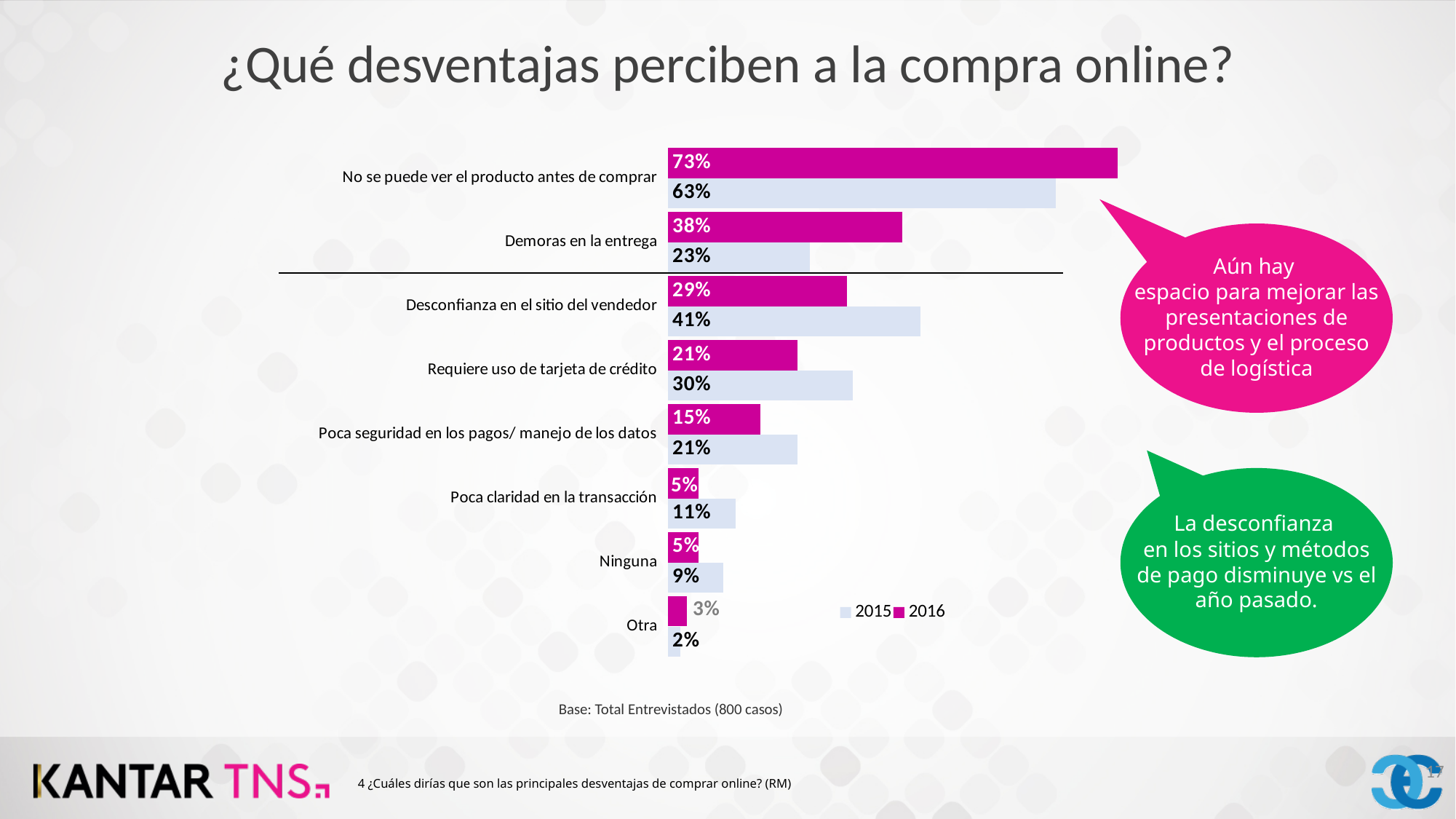
How many categories are shown in the chart? 8 Which category has the highest 2016 value? No se puede ver el producto antes de comprar What kind of chart is shown on the slide? Bar chart What is the 2015 value for "Desconfianza en el sitio del vendedor"? 41% What is the difference between the 2015 and 2016 values for "Desconfianza en el sitio del vendedor"? 12 percentage points What is the 2016 value for "No se puede ver el producto antes de comprar"? 73% For "Requiere uso de tarjeta de crédito", which year has the larger value, 2015 or 2016? 2015 How many series does the legend list? 2 Which category has the lowest 2015 value? Otra What is the difference between the 2016 and 2015 values for "Demoras en la entrega"? 15 percentage points Which colour represents the 2016 series in the chart? Magenta What is the 2016 value for "Demoras en la entrega"? 38%